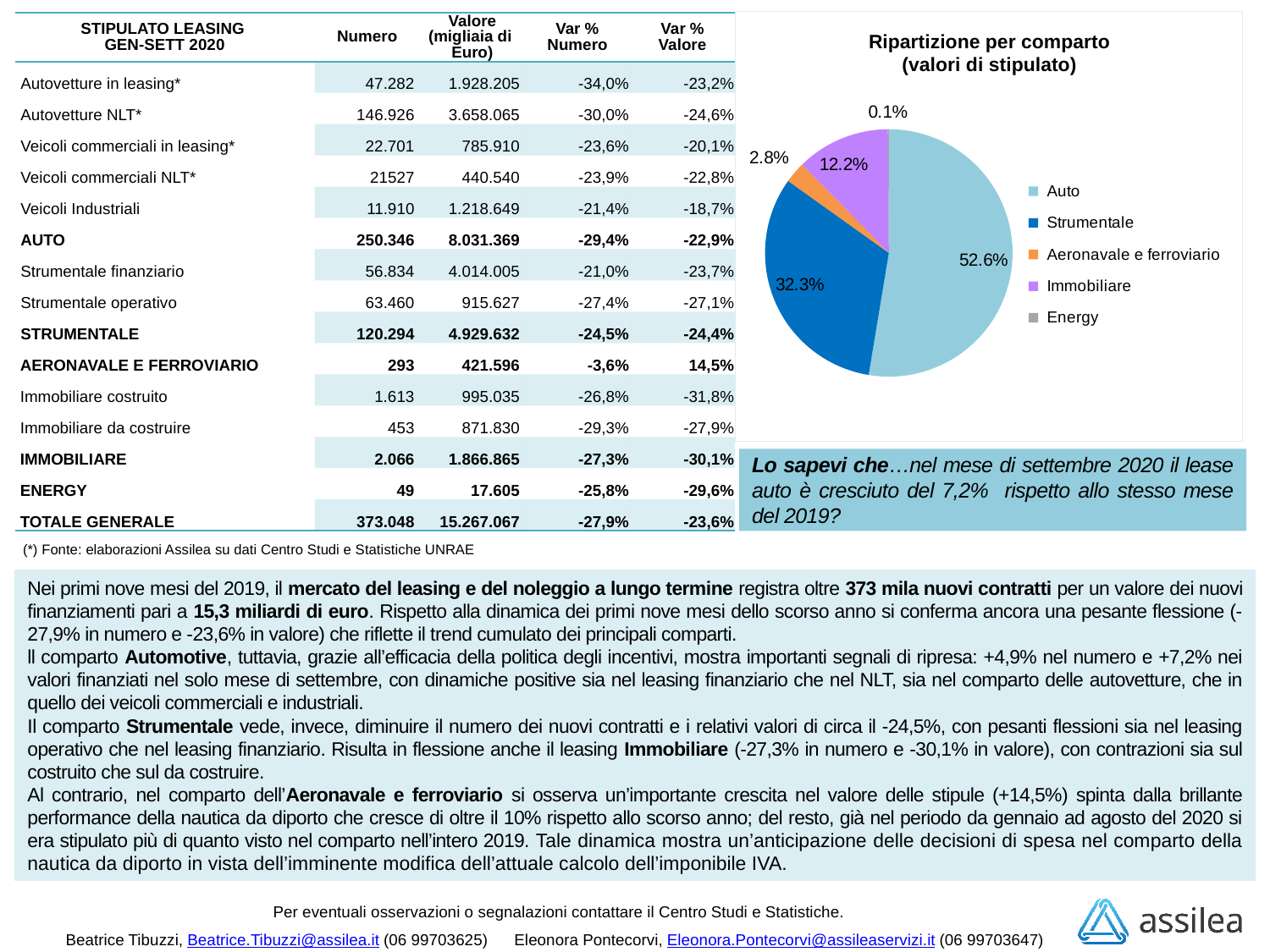
What is the title of the pie chart? Ripartizione per comparto (valori di stipulato) What share of the pie does Immobiliare represent? 12.2% Which category has the smallest slice of the pie? Energy What share of the pie does Energy represent? 0.1% What share of the pie does Aeronavale e ferroviario represent? 2.8% What is the difference in percentage points between the Auto and Strumentale slices? 20.3 How many categories does the pie chart legend list? 5 What kind of chart is shown on the slide? pie chart Which slice is larger, Immobiliare or Aeronavale e ferroviario? Immobiliare Which category has the largest slice of the pie? Auto